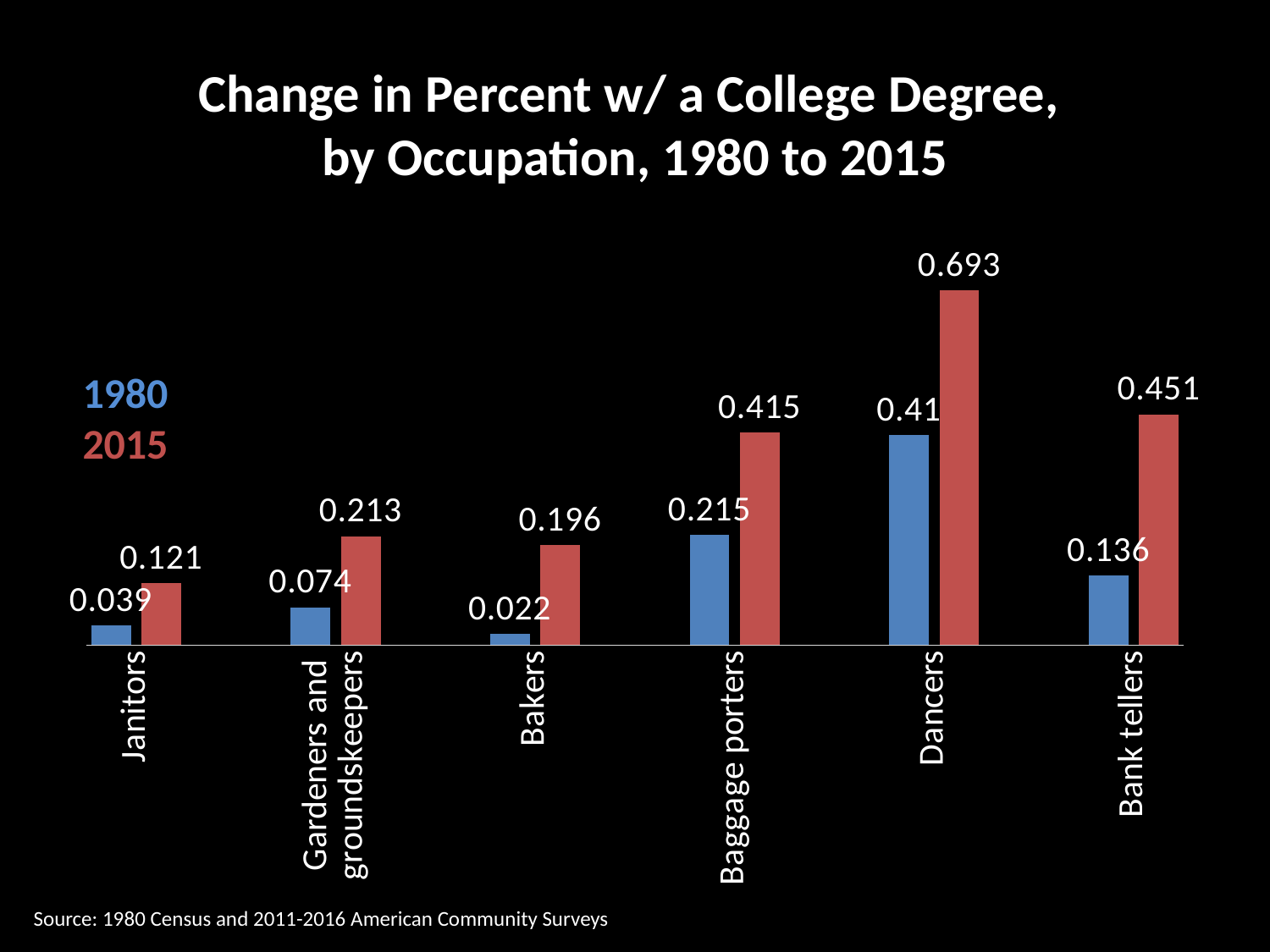
What is the 2015 value for Bank tellers? 0.451 What is the 2015 value for Dancers? 0.693 What is the difference between the 2015 values for Dancers and Bank tellers? 0.242 How many occupations are shown on the chart? 6 What is the 1980 value for Bakers? 0.022 What is the 1980 value for Baggage porters? 0.215 What is the difference between the 2015 and 1980 values for Janitors? 0.082 Which is larger: the 2015 value for Gardeners and groundskeepers or the 2015 value for Bakers? Gardeners and groundskeepers Which occupation has the highest 2015 value? Dancers What kind of chart is shown on the slide? Bar chart Which occupation has the lowest 1980 value? Bakers How many series does the legend list? 2